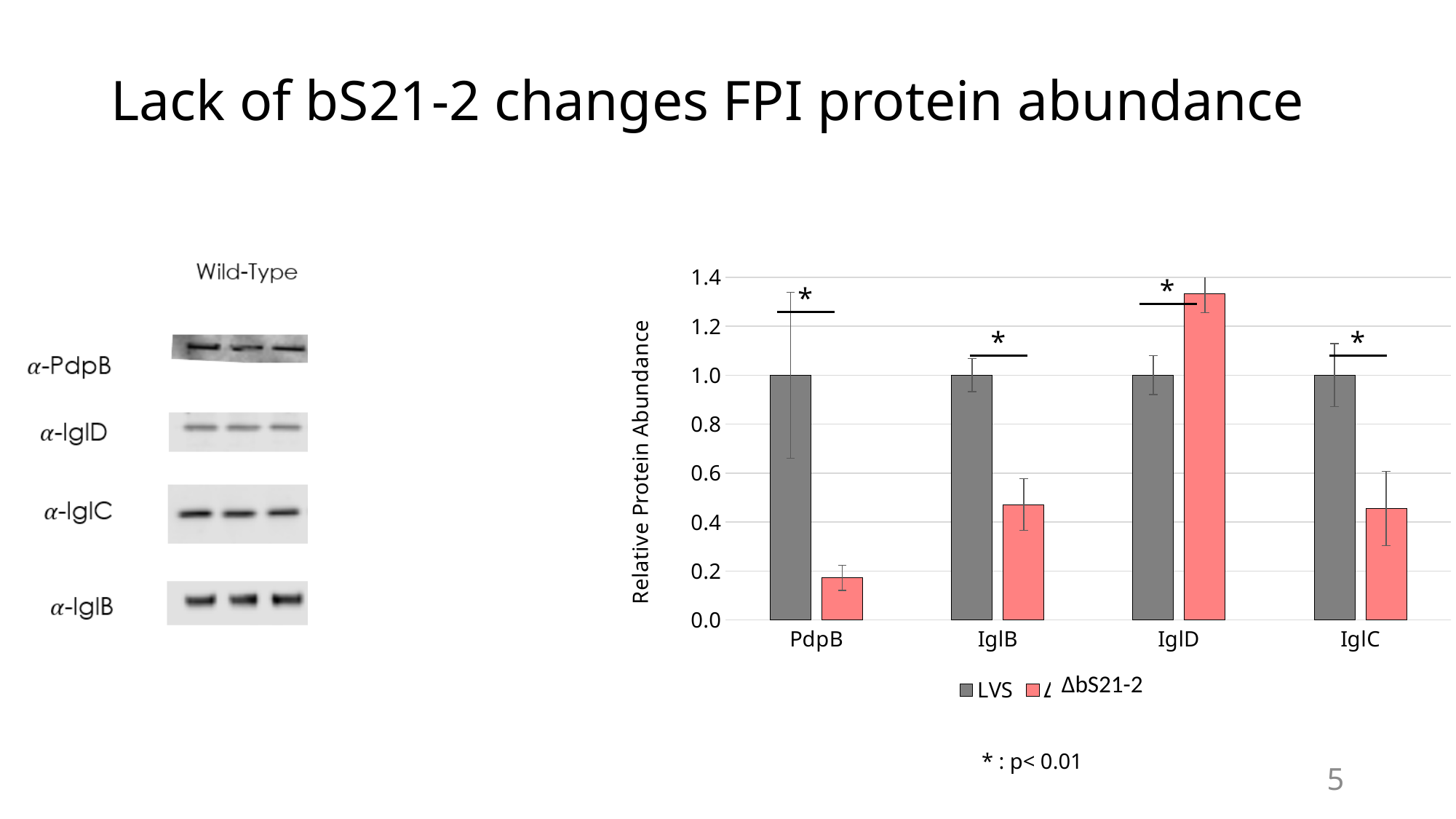
Is the ΔbS21-2 value for IglD greater or less than 1.2? greater Which protein has the lowest ΔbS21-2 value? PdpB Is the ΔbS21-2 value for IglB greater or less than 0.6? less What is the relative protein abundance of LVS for IglC? 1.0 What kind of chart is shown on the slide? bar chart How many series does the chart's legend list? 2 For PdpB, which series has the larger value, LVS or ΔbS21-2? LVS Which protein has the highest ΔbS21-2 value? IglD For IglD, which series has the larger value, LVS or ΔbS21-2? ΔbS21-2 What is the relative protein abundance of LVS for PdpB? 1.0 How many protein categories are shown on the x axis of the chart? 4 Is the ΔbS21-2 value for PdpB greater or less than 0.4? less